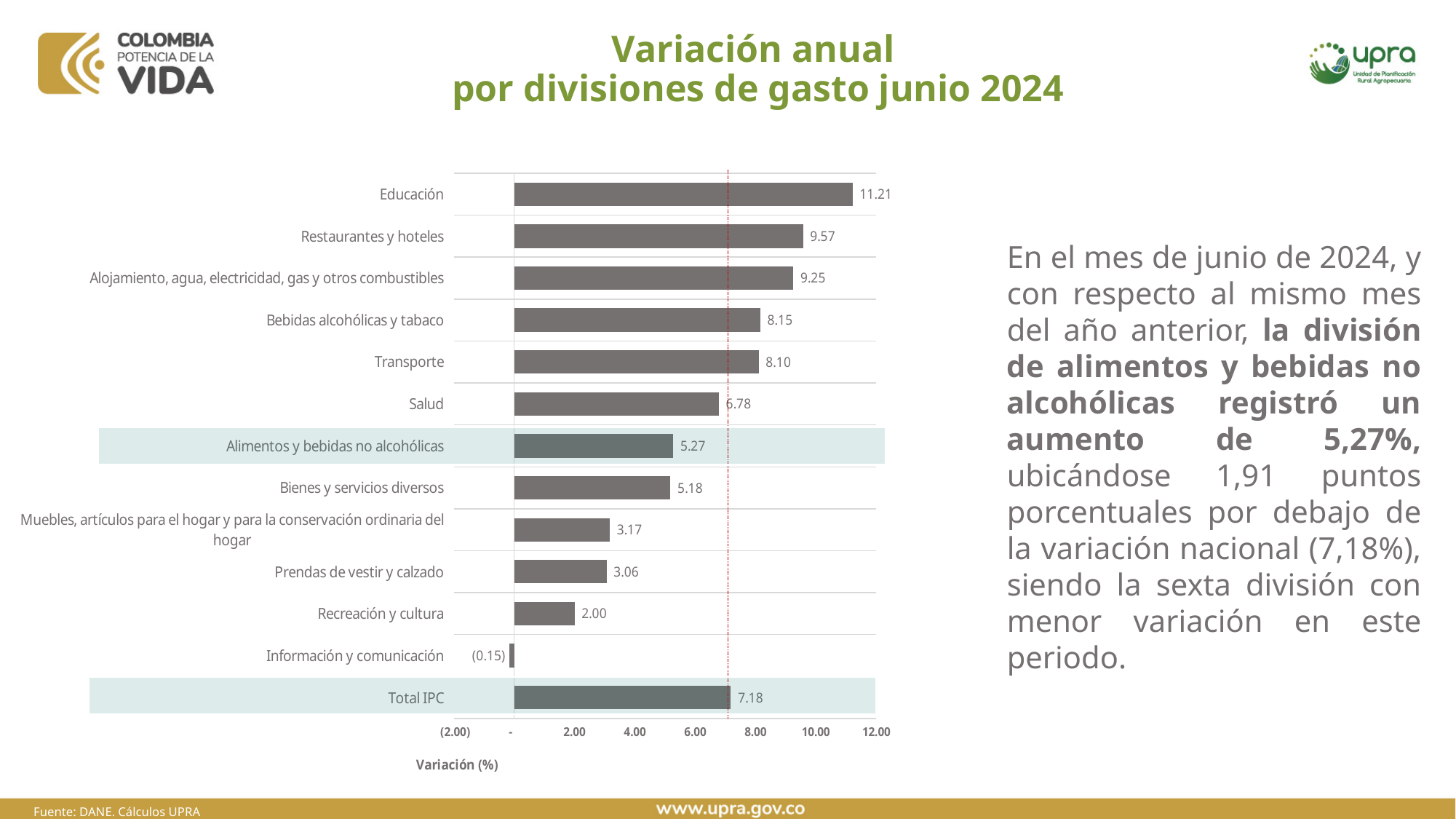
Which category has the highest value? Educación Which is larger, the value for Restaurantes y hoteles or the value for Transporte? Restaurantes y hoteles How many categories are shown on the chart? 13 What is the value for Información y comunicación? (0.15) What is the difference between the values for Total IPC and Alimentos y bebidas no alcohólicas? 1.91 Which category has the lowest value? Información y comunicación What is the value for Alimentos y bebidas no alcohólicas? 5.27 What kind of chart is shown on the slide? Bar chart What is the value for Total IPC? 7.18 What is the value for Educación? 11.21 What is the difference between the values for Educación and Recreación y cultura? 9.21 What is the label of the horizontal axis? Variación (%)